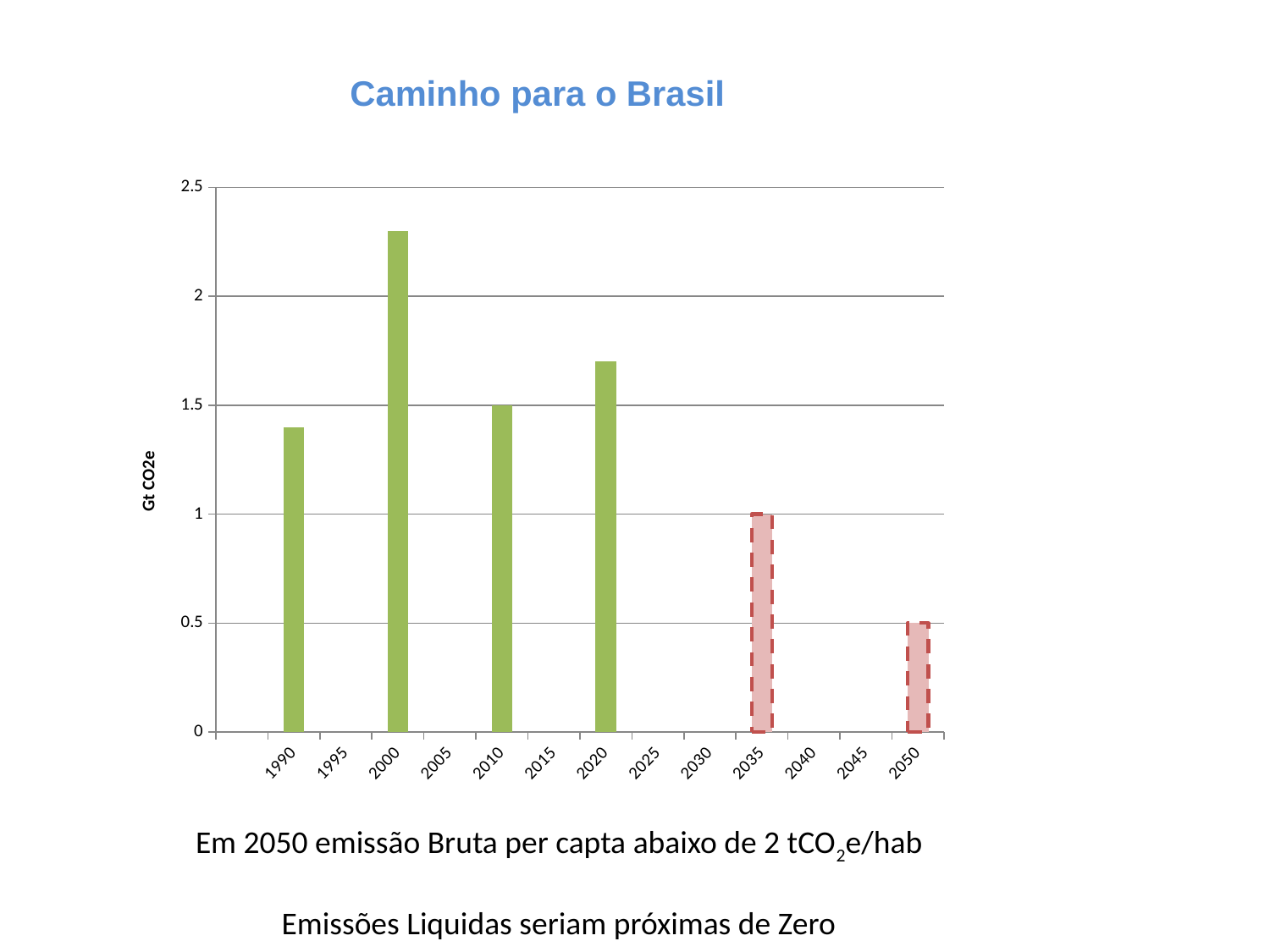
Which year has the lowest bar? 2050 Which year has the highest bar? 2000 What is the value for 2010? 1.5 What is the value for 2035? 1 What is the label on the vertical axis? Gt CO2e How many bars are plotted in the chart? 6 What is the difference between the values for 2035 and 2050? 0.5 What is the value for 2050? 0.5 Which is larger, the value for 1990 or the value for 2020? 2020 Is the value for 2000 greater or less than 2? greater What kind of chart is shown on the slide? bar chart Is the value for 1990 greater or less than 1.5? less